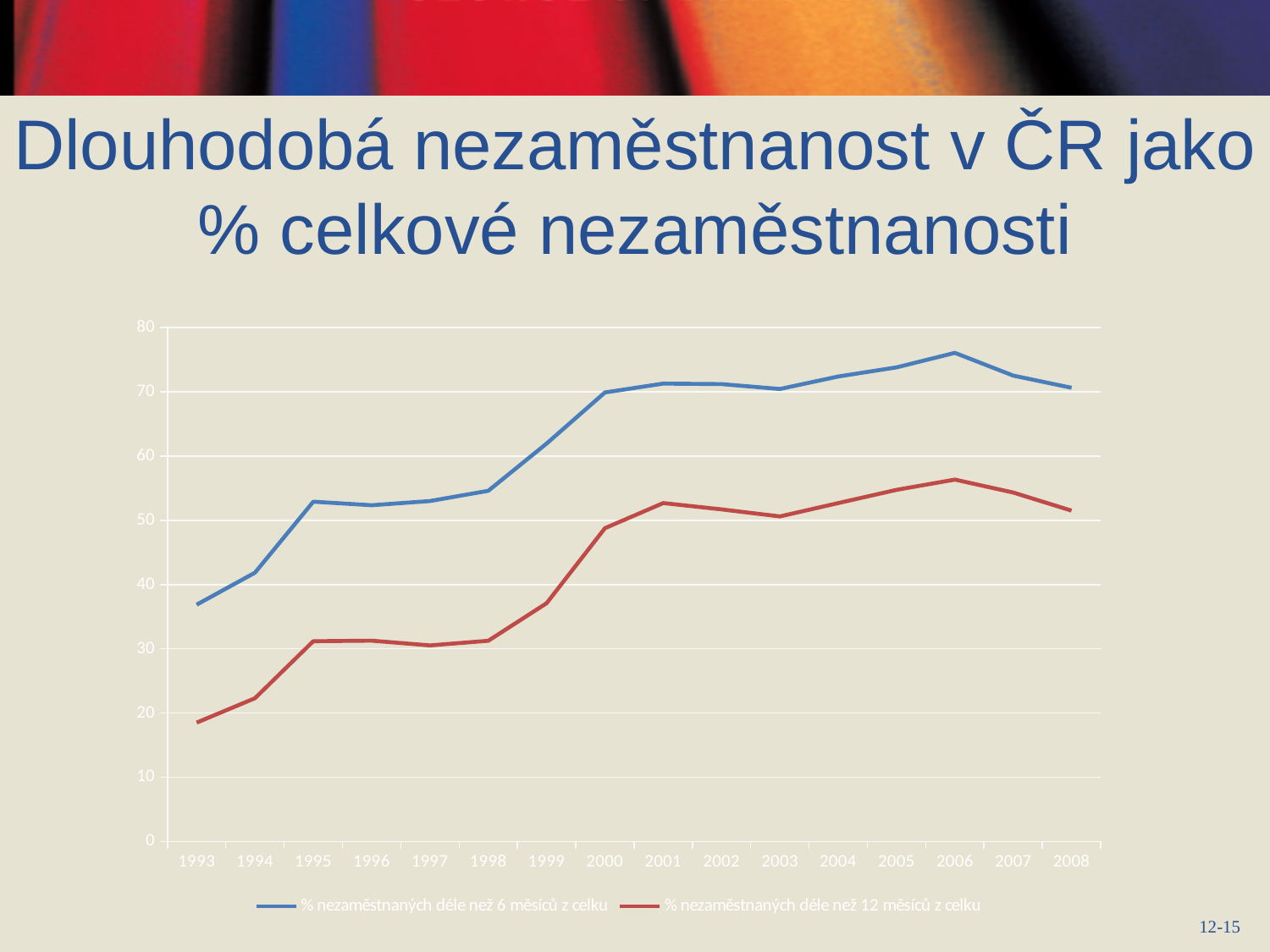
Overall, do the values of '% nezaměstnaných déle než 6 měsíců z celku' rise or fall from 1993 to 2008? rise How many years are shown on the x axis? 16 How many series does the legend list? 2 In which year does the series '% nezaměstnaných déle než 12 měsíců z celku' reach its highest value? 2006 In which year is the series '% nezaměstnaných déle než 12 měsíců z celku' at its lowest? 1993 Is the value for '% nezaměstnaných déle než 12 měsíců z celku' in 1993 greater or less than 20? less Is the value for '% nezaměstnaných déle než 6 měsíců z celku' in 1993 greater or less than 40? less Which series has the higher value in 2000, '% nezaměstnaných déle než 6 měsíců z celku' or '% nezaměstnaných déle než 12 měsíců z celku'? % nezaměstnaných déle než 6 měsíců z celku What kind of chart is shown on the slide? line chart In which year does the series '% nezaměstnaných déle než 6 měsíců z celku' reach its highest value? 2006 Is the value for '% nezaměstnaných déle než 6 měsíců z celku' in 2006 greater or less than 70? greater